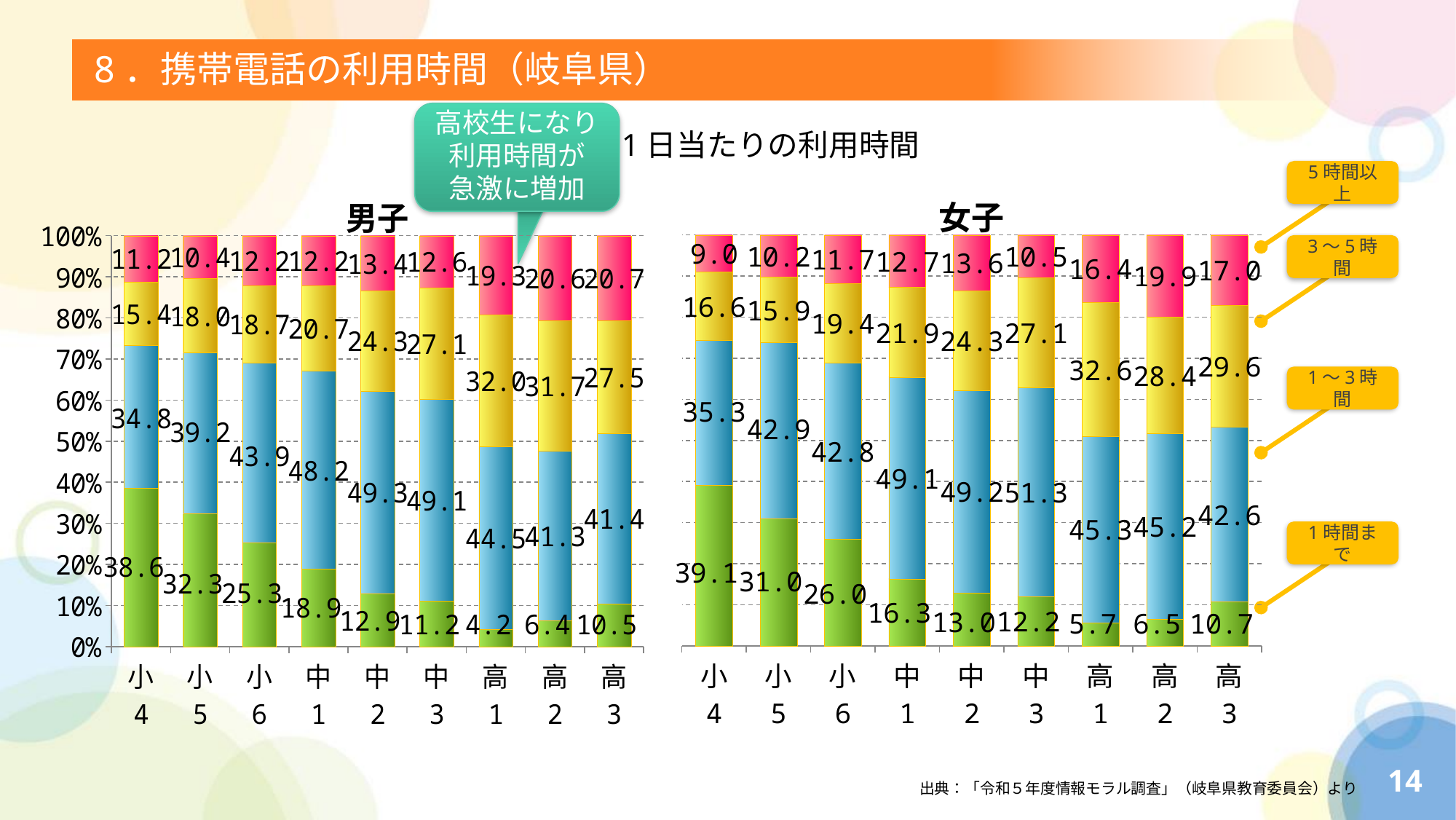
In the 女子 chart, which category has the highest value for 1～3時間? 中3 In the 女子 chart, what is the value for 5時間以上 for 高2? 19.9 In the 男子 chart, which category has the lowest value for 1時間まで? 高1 What is the title of the chart on the right? 女子 In the 男子 chart, what is the value for 1時間まで for 小4? 38.6 In the 男子 chart, what is the value for 3～5時間 for 高1? 32.0 What kind of chart is the 男子 chart? Stacked bar chart How many series does the legend list? 4 In the 男子 chart, what is the difference between the 5時間以上 values for 高3 and 小4? 9.5 How many categories are shown on the x axis of the 女子 chart? 9 In the 女子 chart, which is larger: the 1時間まで value for 小4 or for 小5? 小4 In the 男子 chart, does the 1時間まで value rise or fall from 小4 to 高1? Fall